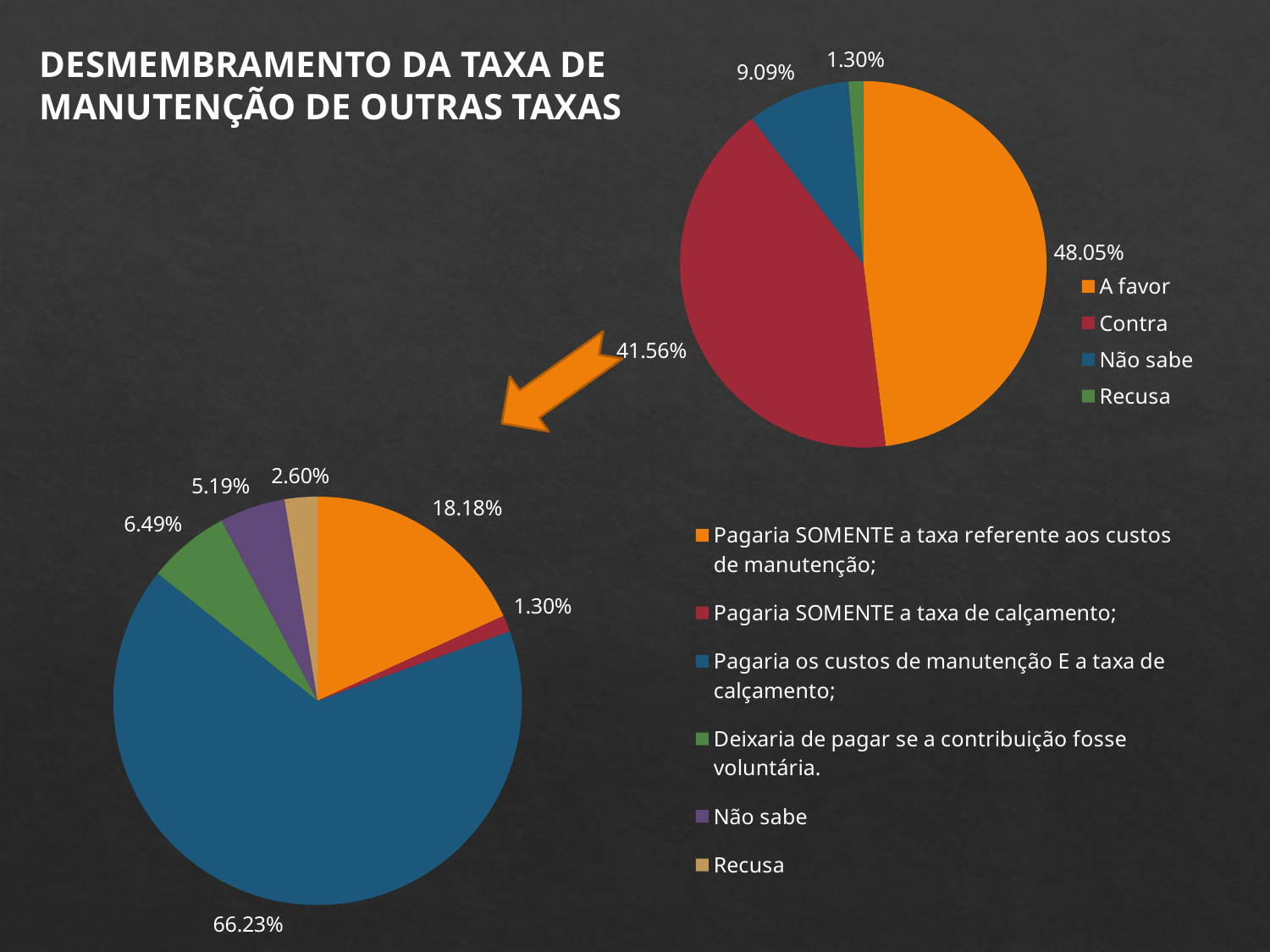
In the pie chart at the top right of the slide, what is the difference between the "A favor" and "Contra" shares? 6.49% What kind of chart is shown at the bottom left of the slide? Pie chart In the pie chart at the top right of the slide, what share is labelled for "Contra"? 41.56% In the pie chart at the bottom left of the slide, which is larger: "Deixaria de pagar se a contribuição fosse voluntária" or "Recusa"? Deixaria de pagar se a contribuição fosse voluntária In the pie chart at the bottom left of the slide, which category has the largest slice? Pagaria os custos de manutenção E a taxa de calçamento In the pie chart at the bottom left of the slide, what share is labelled for "Pagaria os custos de manutenção E a taxa de calçamento"? 66.23% In the pie chart at the bottom left of the slide, what share is labelled for "Não sabe"? 5.19% In the pie chart at the top right of the slide, what colour is the "Não sabe" slice? Blue In the pie chart at the top right of the slide, what share is labelled for "A favor"? 48.05% In the pie chart at the top right of the slide, how many categories does the legend list? 4 In the pie chart at the bottom left of the slide, how many categories does the legend list? 6 In the pie chart at the top right of the slide, which category has the smallest slice? Recusa